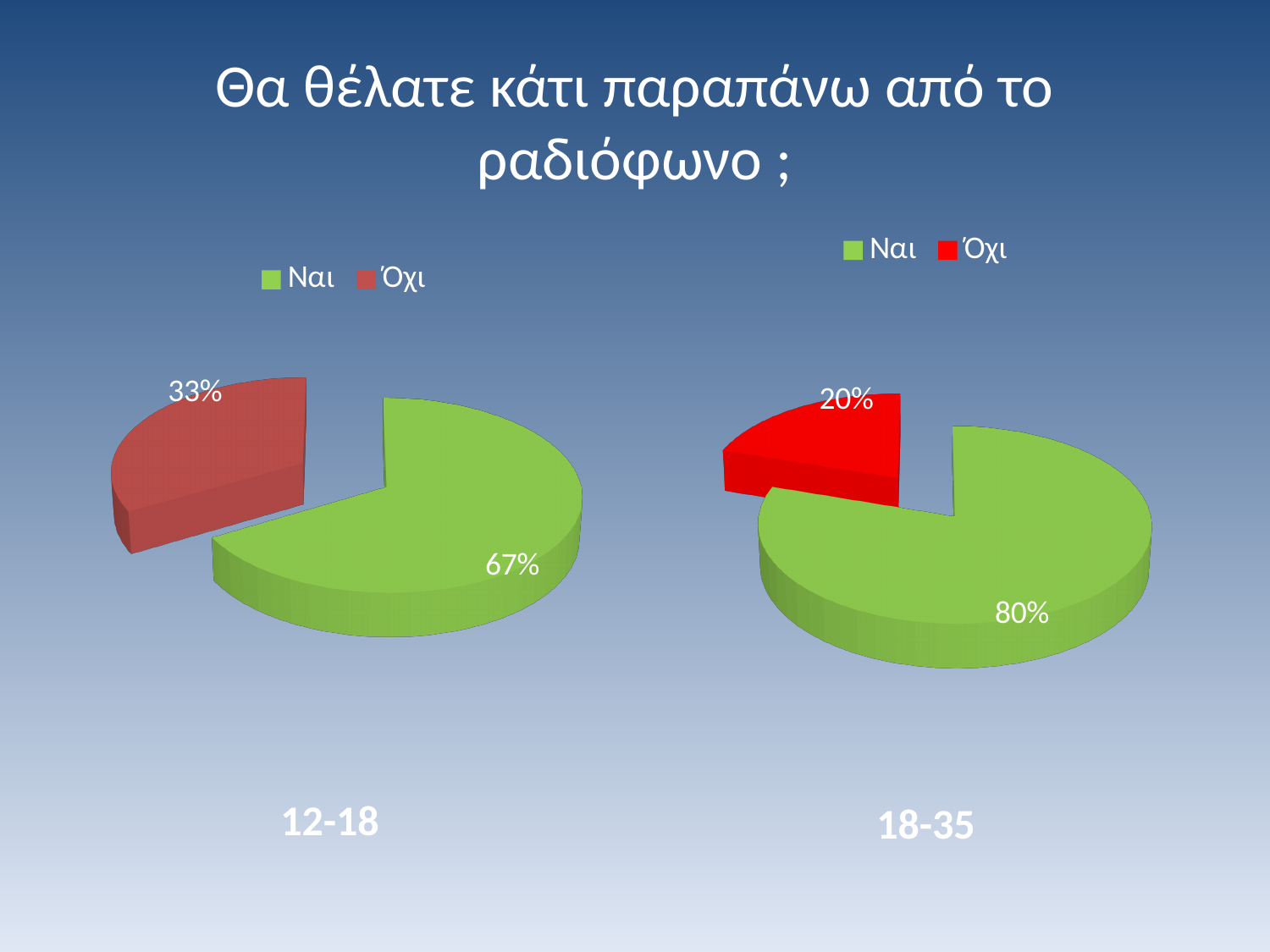
In the 18-35 pie chart, what percentage is shown for Ναι? 80% In the 18-35 pie chart, what percentage is shown for Όχι? 20% In the 12-18 pie chart, what is the difference between the Ναι and Όχι percentages? 34% What type of chart is used on the left side of the slide (12-18)? Pie chart In the 18-35 pie chart, what is the difference between the Ναι and Όχι percentages? 60% In the 18-35 pie chart, which category has the smallest slice? Όχι In the 12-18 pie chart, what percentage is shown for Ναι? 67% How many slices does the 18-35 pie chart have? 2 In the 12-18 pie chart, which category has the largest slice? Ναι In the 12-18 pie chart, what percentage is shown for Όχι? 33% How many entries does the legend of the 12-18 chart list? 2 Which chart has the larger Ναι share, the 12-18 chart or the 18-35 chart? 18-35